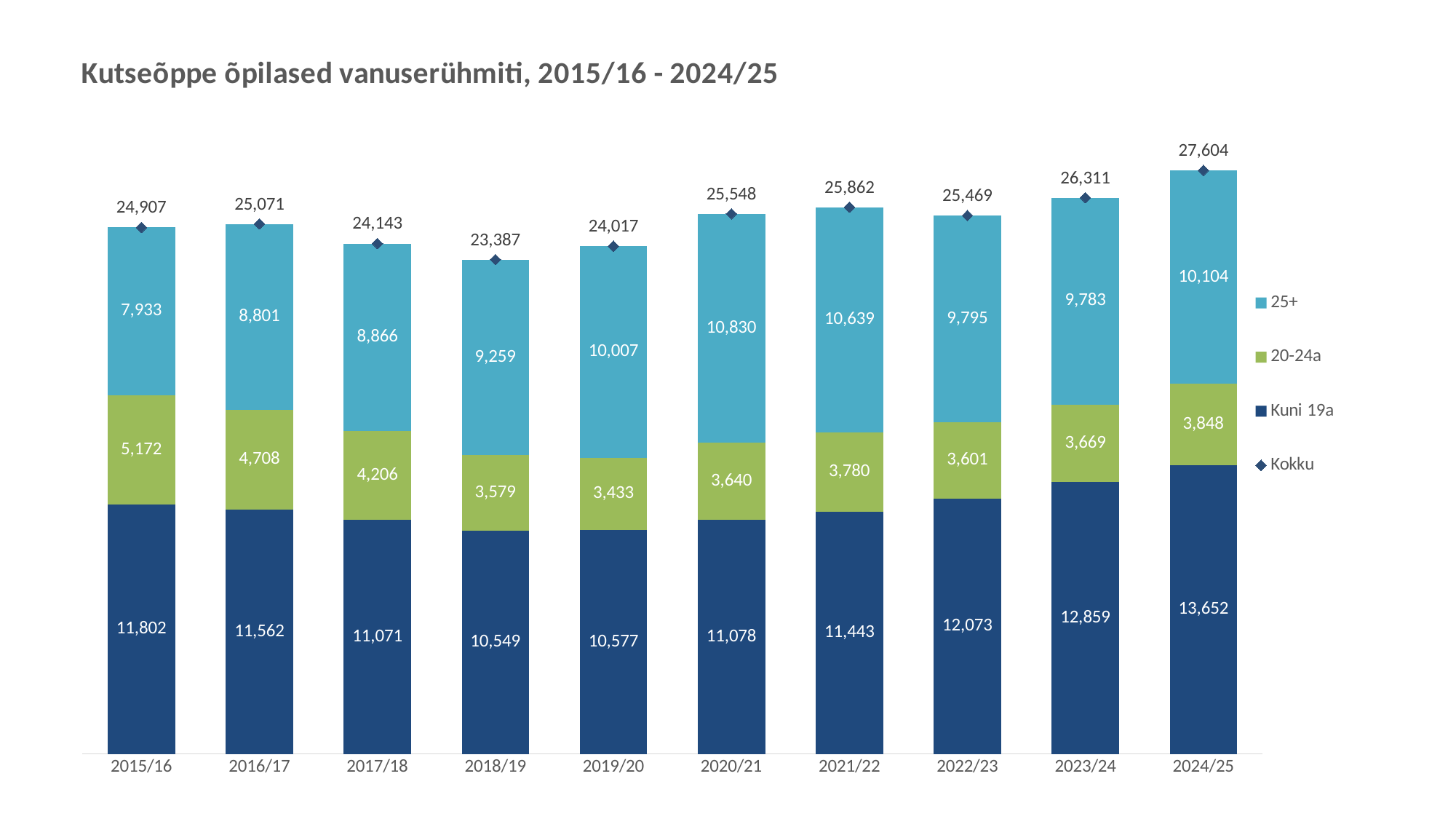
What is the value for Kuni 19a in 2024/25? 13,652 Which year has the highest Kokku value? 2024/25 In 2023/24, which is larger: the Kuni 19a value or the 25+ value? Kuni 19a How many academic years are shown on the x axis? 10 What is the value for 25+ in 2019/20? 10,007 How many entries does the legend list? 4 What is the Kokku value for 2018/19? 23,387 Which year has the lowest value for 20-24a? 2019/20 Does the Kuni 19a value rise or fall from 2018/19 to 2024/25? Rise What kind of chart is this? Stacked bar chart with a line/marker series for totals What is the difference between the 25+ value in 2024/25 and in 2015/16? 2,171 What is the total of the stacked bar for 2020/21? 25,548